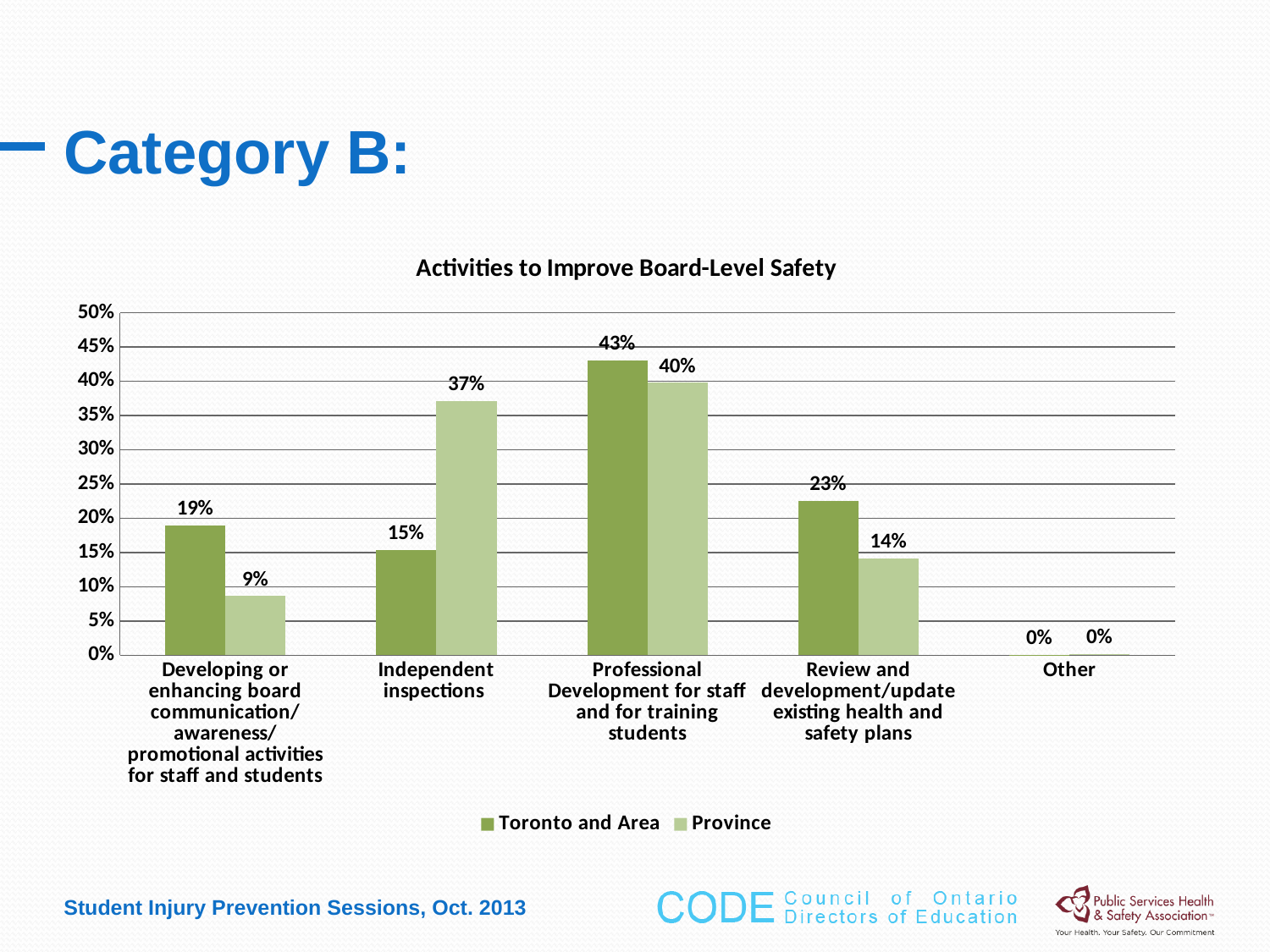
What is the Province value for Professional Development for staff and for training students? 40% How many categories are shown on the x axis? 5 What is the difference between the Province and Toronto and Area values for Independent inspections? 22% Is the Toronto and Area value for Review and development/update existing health and safety plans greater or less than 20%? greater Which category has the highest Toronto and Area value? Professional Development for staff and for training students What is the difference between the Toronto and Area and Province values for Developing or enhancing board communication/awareness/promotional activities for staff and students? 10% What is the Toronto and Area value for Independent inspections? 15% For Independent inspections, which is larger: Toronto and Area or Province? Province What is the Province value for Review and development/update existing health and safety plans? 14% What type of chart is shown? Bar chart Which category has the lowest Province value? Other How many series does the legend list? 2